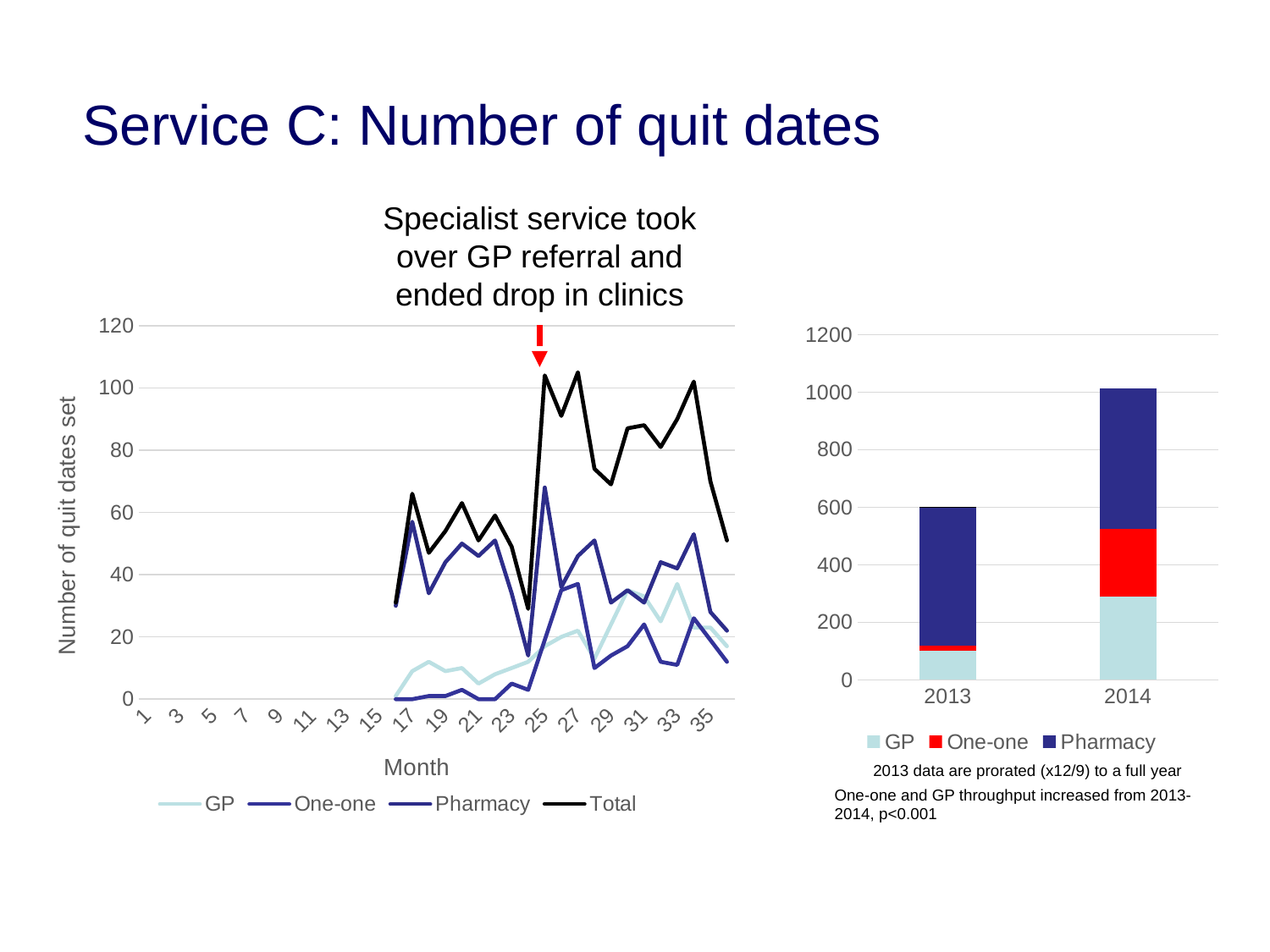
In the right chart, which year has the taller stacked bar, 2013 or 2014? 2014 In the left chart, does the Total line rise or fall between month 33 and month 36? fall What kind of chart is the chart on the right of the slide? stacked bar chart What is the y-axis title of the left chart? Number of quit dates set What kind of chart is the chart on the left of the slide? line chart How many years are shown on the x axis of the right chart? 2 In the right chart, which segment is the largest in the 2014 bar? Pharmacy In the left chart, is the Total value at month 25 greater or less than 80? greater In the right chart, is the total height of the 2014 bar greater or less than 800? greater How many series does the legend of the left chart list? 4 How many series does the legend of the right chart list? 3 In the right chart, is the total height of the 2013 bar greater or less than 800? less